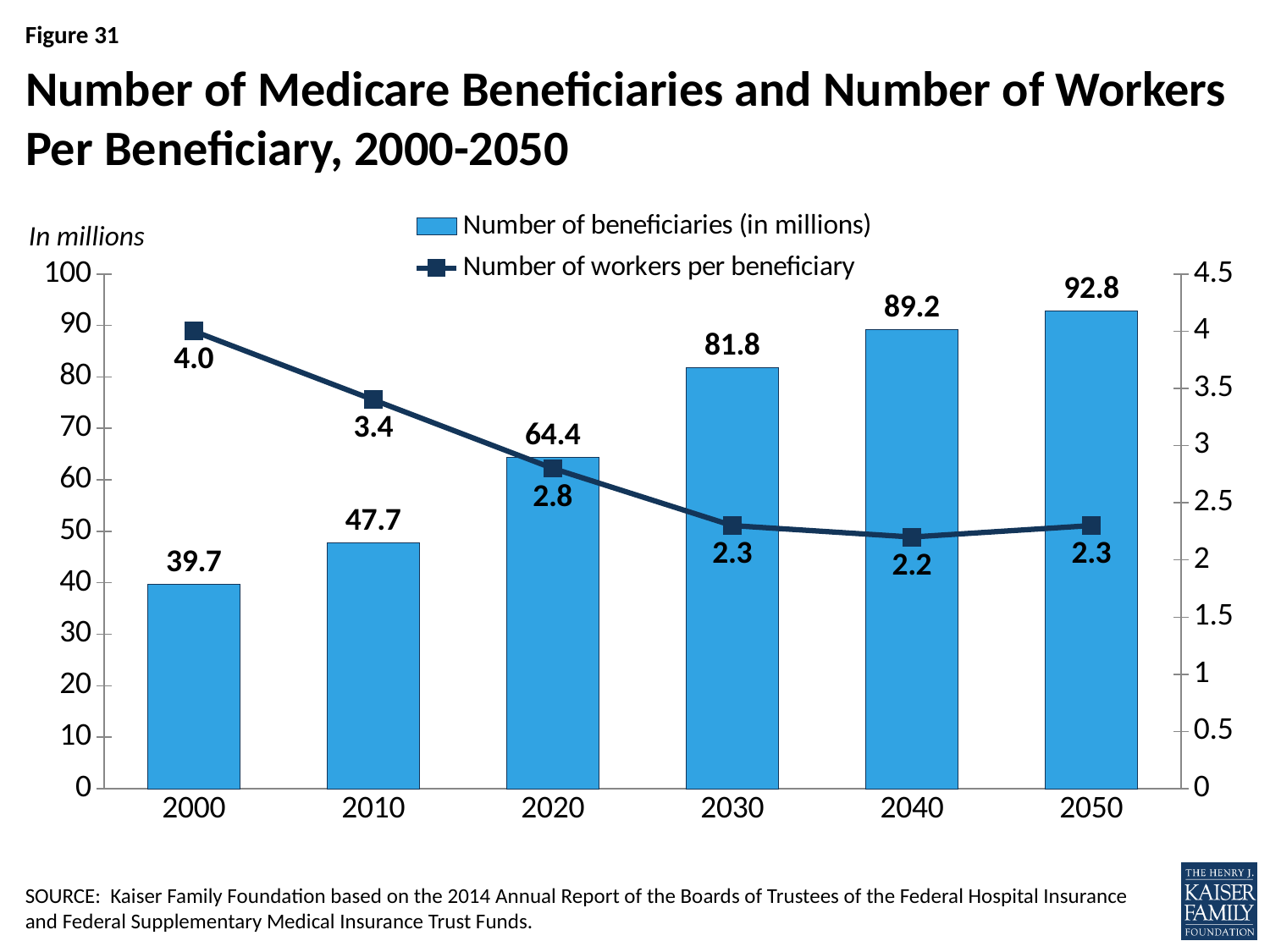
What kinds of chart are combined on this slide? Bar chart and line chart What is the number of workers per beneficiary in 2010? 3.4 In which year is the number of beneficiaries highest? 2050 What is the difference in workers per beneficiary between 2000 and 2050? 1.7 Does the number of beneficiaries rise or fall from 2000 to 2050? Rise What unit is given for the left axis? In millions How many series does the legend list? 2 In which year is the number of workers per beneficiary lowest? 2040 What is the difference in the number of beneficiaries (in millions) between 2050 and 2000? 53.1 What is the number of Medicare beneficiaries (in millions) in 2020? 64.4 How many years are shown on the x axis? 6 Which year has more beneficiaries, 2030 or 2010? 2030